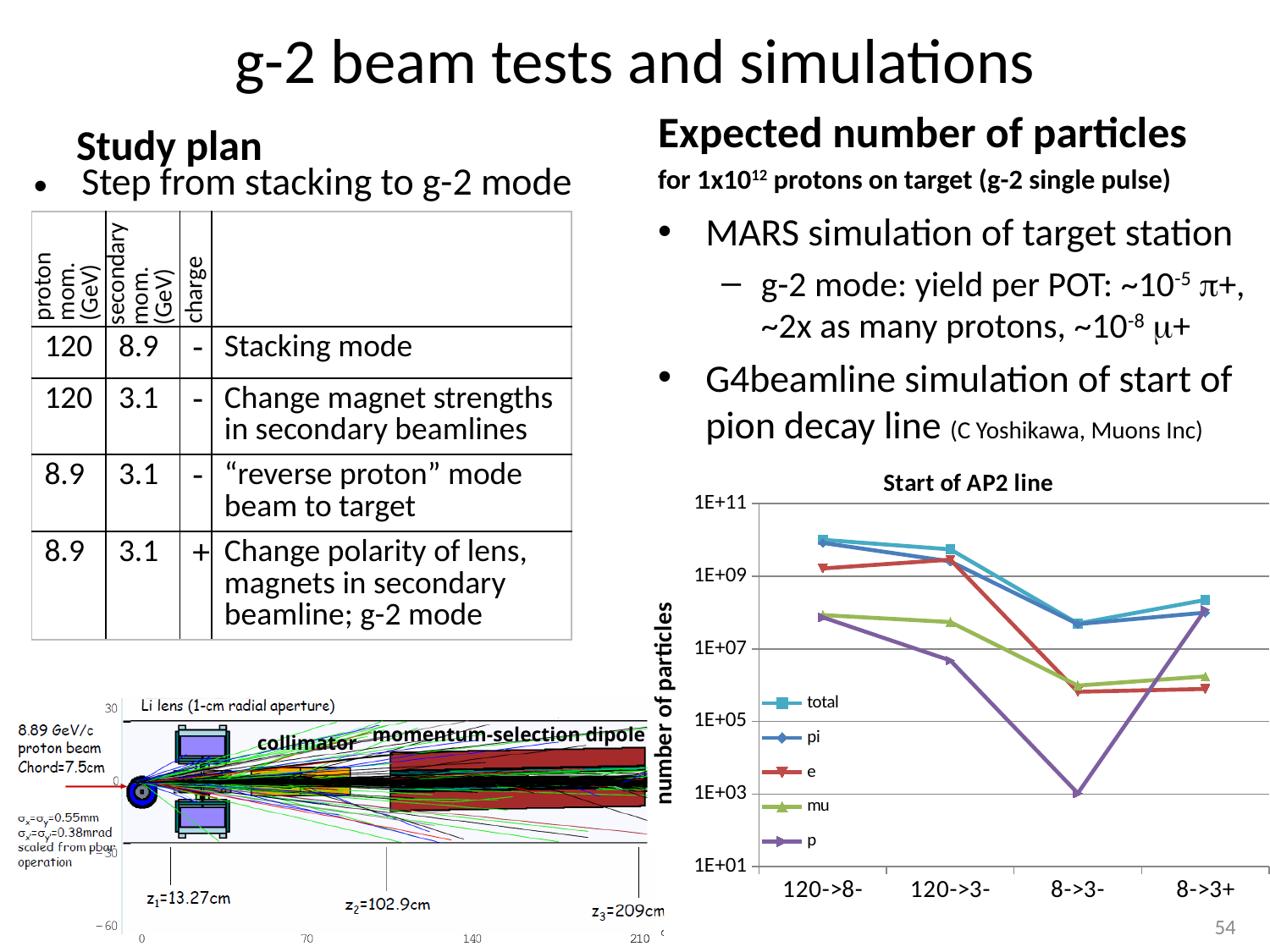
What is the title of the line chart on the slide? Start of AP2 line What is the y-axis label of the 'Start of AP2 line' chart? number of particles In the 'Start of AP2 line' chart, is the value of 'p' at 8->3- greater or less than 1E+05? less In the 'Start of AP2 line' chart, at which category does the 'p' series reach its lowest value? 8->3- In the 'Start of AP2 line' chart, is the value of 'total' at 120->8- greater or less than 1E+09? greater In the 'Start of AP2 line' chart, does the 'p' series rise or fall from 120->8- to 8->3-? fall What kind of chart is the 'Start of AP2 line' chart? line chart In the 'Start of AP2 line' chart, is the value of 'mu' at 8->3- greater or less than 1E+07? less How many series does the legend of the 'Start of AP2 line' chart list? 5 In the 'Start of AP2 line' chart, which series has the highest value at 120->8-? total How many categories are shown on the x axis of the 'Start of AP2 line' chart? 4 In the 'Start of AP2 line' chart, at 8->3-, which is larger: 'total' or 'p'? total